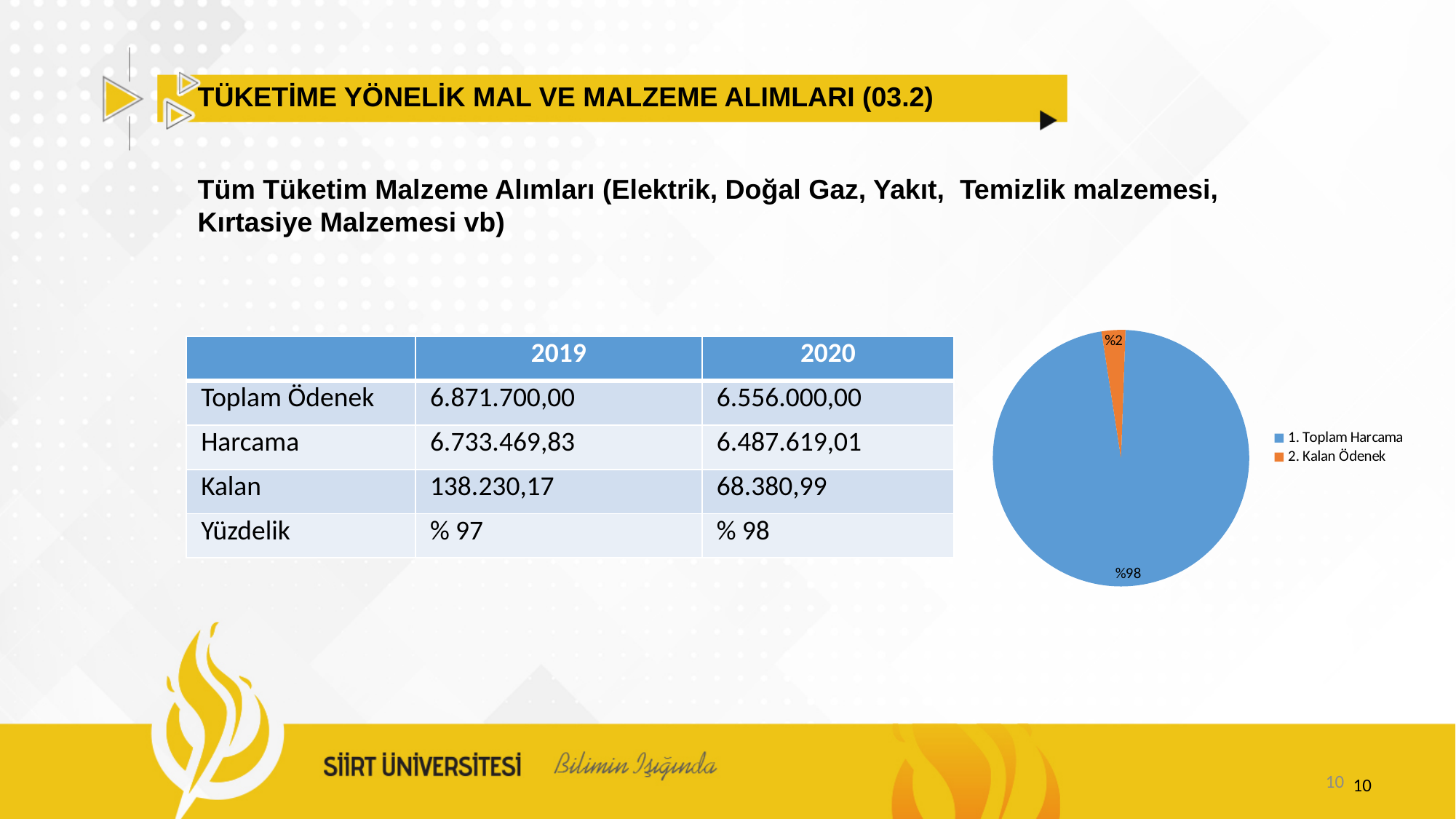
How many entries does the pie chart's legend list? 2 Which is larger in the pie chart, '1. Toplam Harcama' or '2. Kalan Ödenek'? 1. Toplam Harcama Which slice of the pie chart is the largest? 1. Toplam Harcama What colour is the '2. Kalan Ödenek' slice in the pie chart? orange Which slice of the pie chart is the smallest? 2. Kalan Ödenek What is the value labelled on the blue slice of the pie chart? %98 What share of the pie does '2. Kalan Ödenek' represent? %2 What kind of chart is shown on the slide? pie chart What is the difference in percentage points between the '1. Toplam Harcama' slice and the '2. Kalan Ödenek' slice? %96 How many slices does the pie chart have? 2 What is the value labelled on the orange slice of the pie chart? %2 What share of the pie does '1. Toplam Harcama' represent? %98